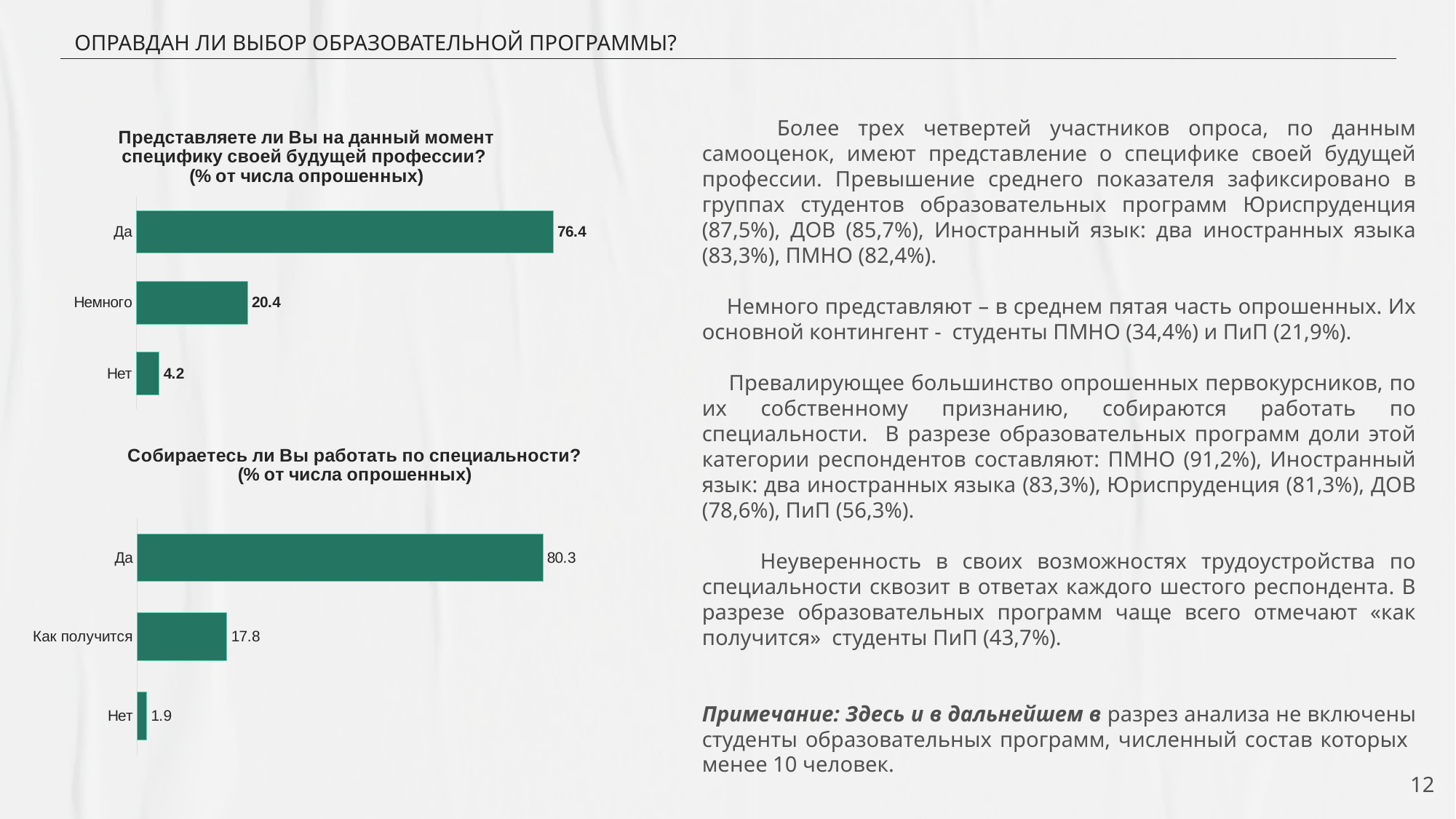
In the top chart, what is the difference between the values for "Да" and "Немного"? 56.0 In the bottom chart, what is the difference between the values for "Как получится" and "Нет"? 15.9 What type of chart is the top chart? Bar chart In the bottom chart, what is the value for "Как получится"? 17.8 In the bottom chart, what is the value for "Нет"? 1.9 How many categories are shown in the bottom chart? 3 In the top chart ("Представляете ли Вы на данный момент специфику своей будущей профессии?"), what is the value for "Да"? 76.4 In the top chart, what is the value for "Немного"? 20.4 In the bottom chart, which category has the highest value? Да In the top chart, which category has the lowest value? Нет In the top chart, what is the value for "Нет"? 4.2 In the bottom chart ("Собираетесь ли Вы работать по специальности?"), what is the value for "Да"? 80.3